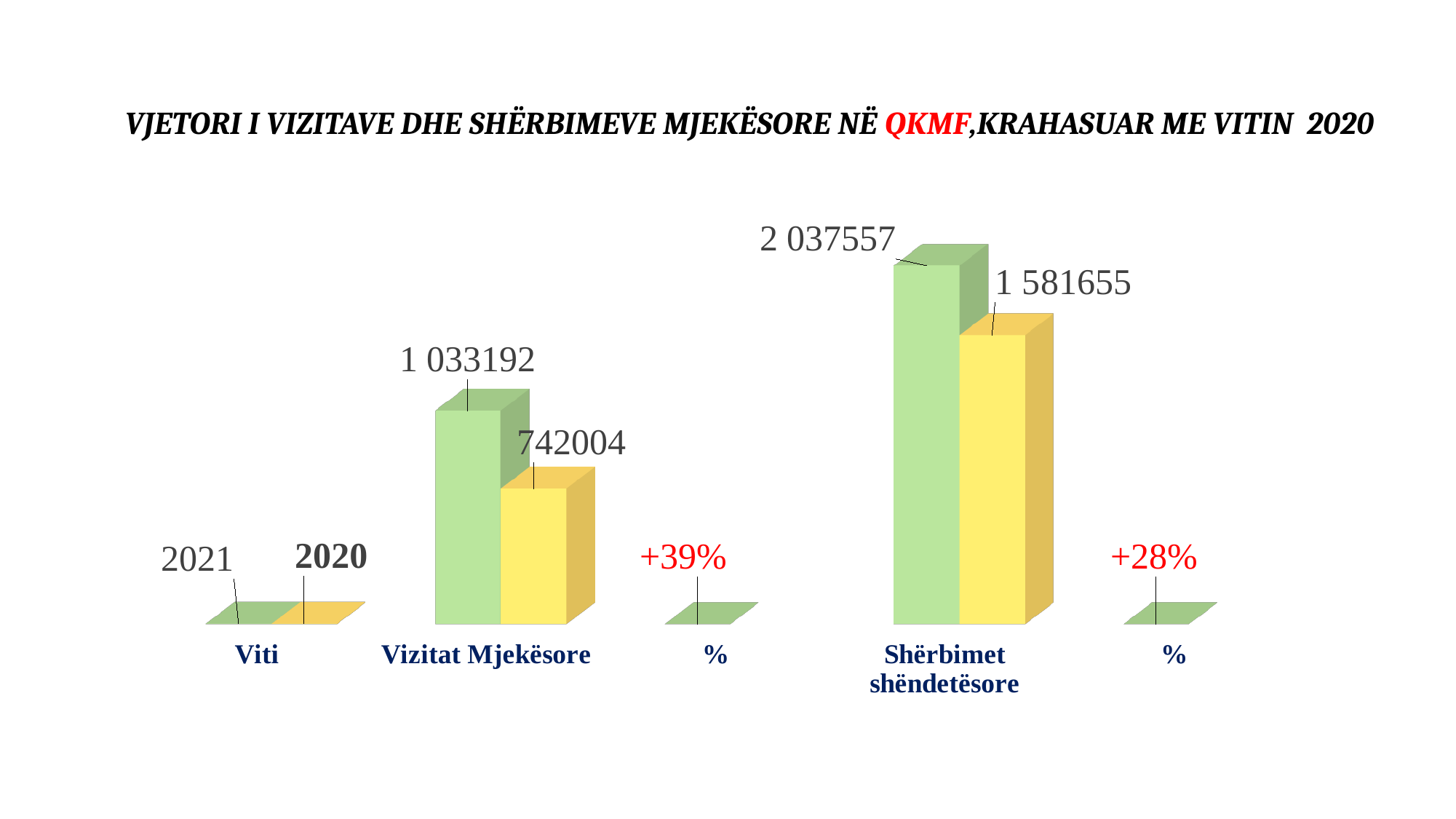
What is the difference between the 2021 and 2020 values for Shërbimet shëndetësore? 455902 What is the difference between the 2021 and 2020 values for Vizitat Mjekësore? 291188 What percentage change is shown next to Vizitat Mjekësore? +39% What is the value for Shërbimet shëndetësore in 2020? 1 581655 What percentage change is shown next to Shërbimet shëndetësore? +28% What is the value for Shërbimet shëndetësore in 2021? 2 037557 What is the value for Vizitat Mjekësore in 2020? 742004 What kind of chart is shown on the slide? bar chart Which is larger for Vizitat Mjekësore, the 2021 value or the 2020 value? 2021 Which year is represented by the green bars? 2021 Which category has the highest plotted value on the chart? Shërbimet shëndetësore What is the value for Vizitat Mjekësore in 2021? 1 033192